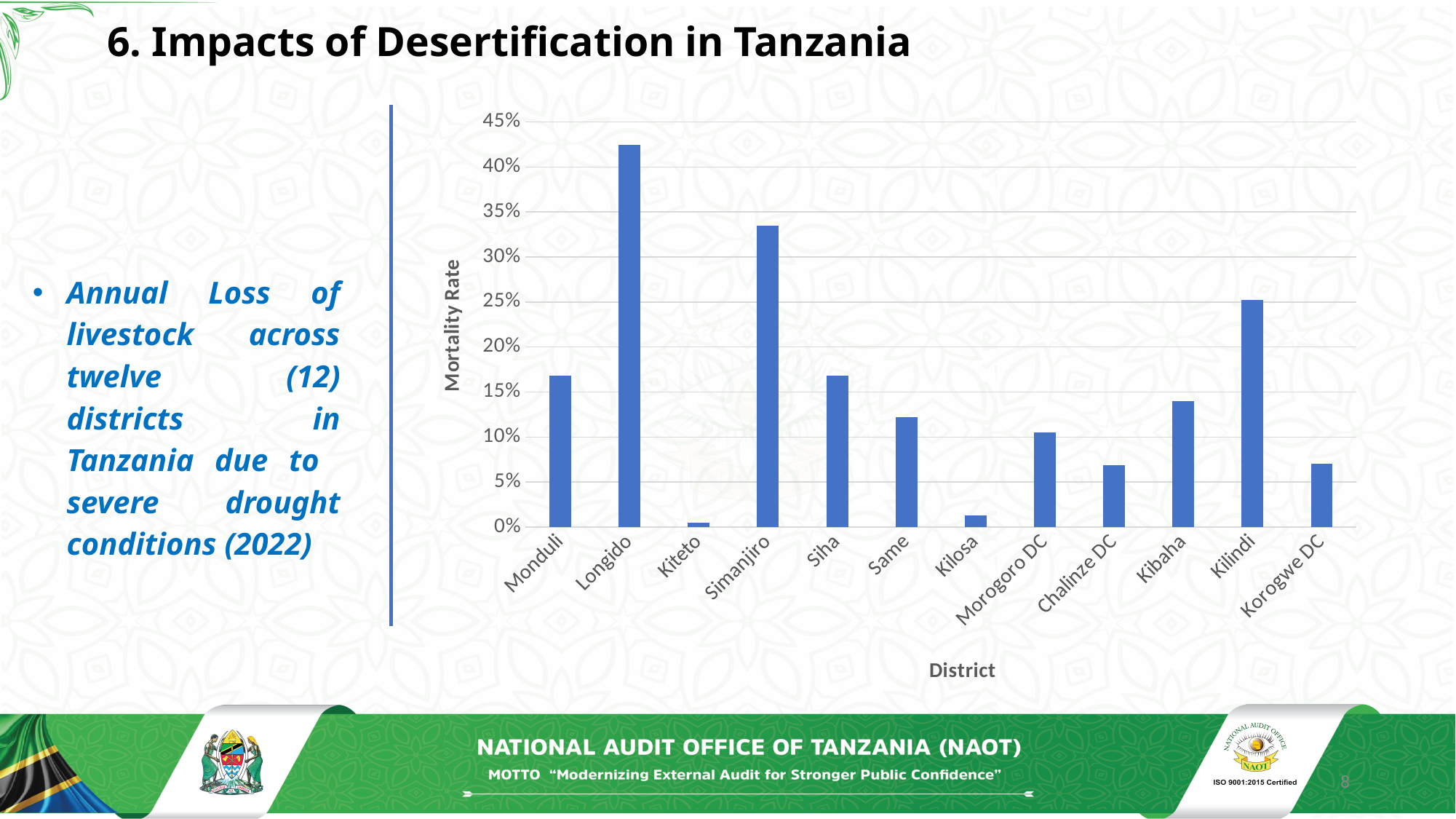
Is the mortality rate for Kilindi greater or less than 20%? greater What is the label of the vertical axis of the chart? Mortality Rate What is the label of the horizontal axis of the chart? District How many districts are shown on the x axis of the chart? 12 Is the mortality rate for Same greater or less than 15%? less Is the mortality rate for Chalinze DC greater or less than 10%? less Which district has the highest mortality rate in the chart? Longido What kind of chart is shown on the slide? bar chart Which district has a higher mortality rate, Simanjiro or Kilindi? Simanjiro Which district has the lowest mortality rate in the chart? Kiteto